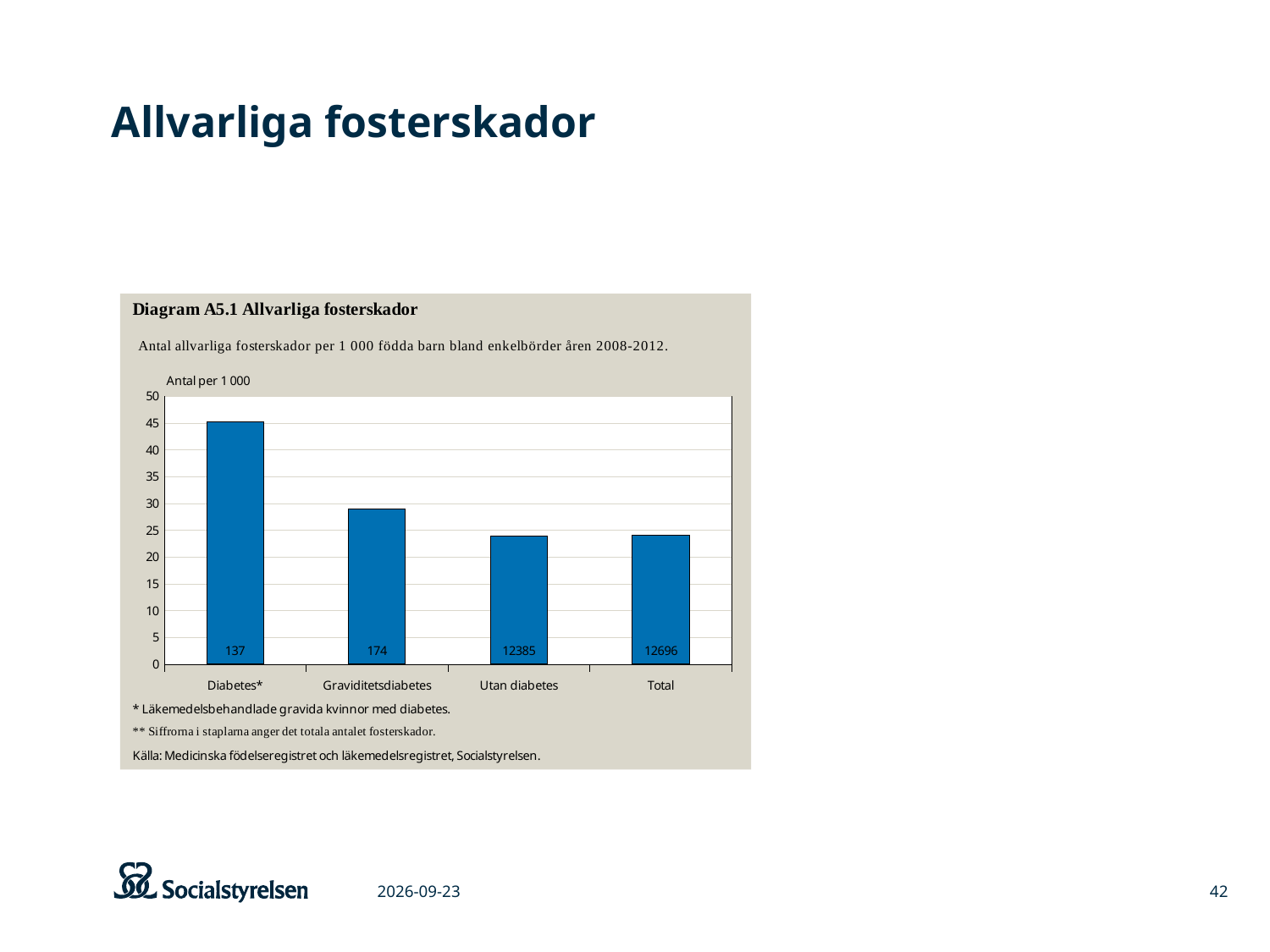
Is the value for Graviditetsdiabetes greater or less than 25? greater Is the value for Total greater or less than 20? greater What kind of chart is shown on the slide? bar chart What is the label on the y axis of the chart? Antal per 1 000 What number is printed inside the Diabetes* bar? 137 Which bar is taller, Diabetes* or Graviditetsdiabetes? Diabetes* How many categories are shown on the x axis of the chart? 4 Is the value for Diabetes* greater or less than 40? greater Which category has the highest bar in the chart? Diabetes* Which bar is taller, Graviditetsdiabetes or Utan diabetes? Graviditetsdiabetes What number is printed inside the Utan diabetes bar? 12385